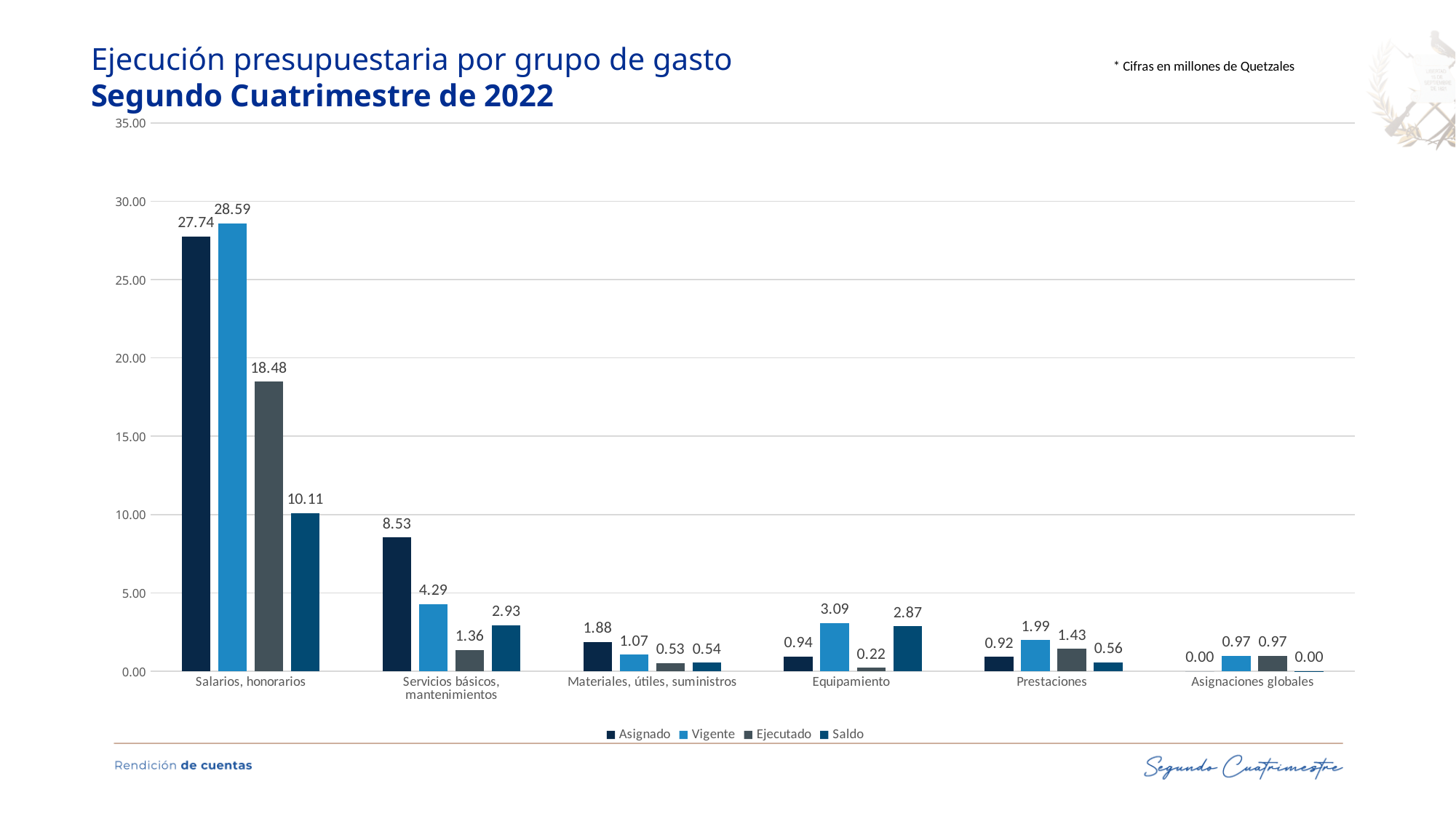
What is the Asignado value for Prestaciones? 0.92 What is the Vigente value for Salarios, honorarios? 28.59 What is the difference between the Vigente and Ejecutado values for Salarios, honorarios? 10.11 What is the Ejecutado value for Servicios básicos, mantenimientos? 1.36 How many series does the legend list? 4 What kind of chart is shown on the slide? Bar chart What is the Saldo value for Equipamiento? 2.87 Which category has the highest Ejecutado value? Salarios, honorarios How many expense groups (categories) are shown on the x axis? 6 Which is larger for Equipamiento: the Asignado value or the Vigente value? Vigente What unit are the figures in, according to the note on the slide? Millones de Quetzales Which category has the lowest Asignado value? Asignaciones globales